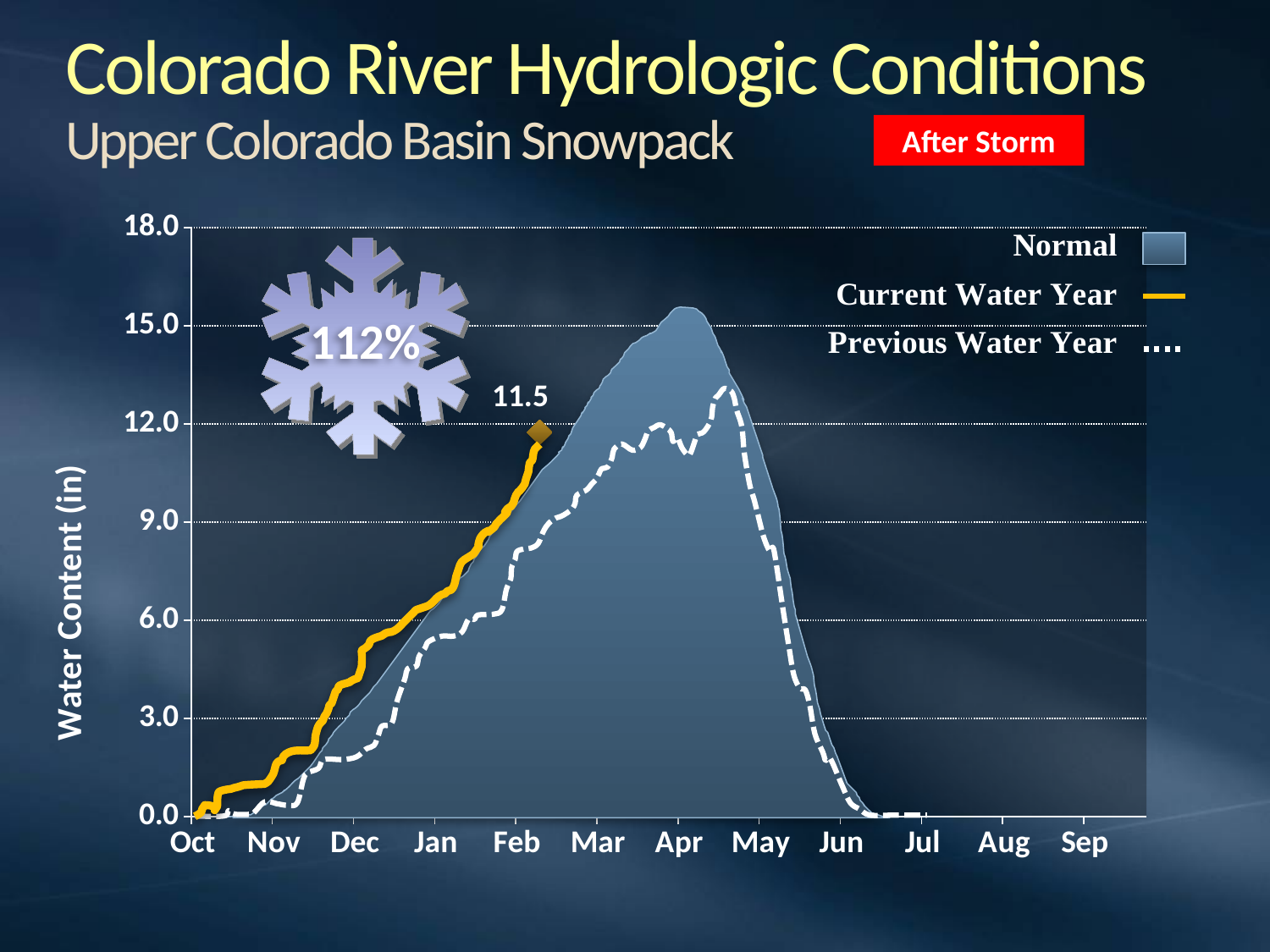
Is the peak of the Normal series greater or less than 15.0? greater At Jan, which is higher: the Current Water Year line or the Previous Water Year line? Current Water Year Around which month does the Normal series reach its highest value? Apr Does the Current Water Year line rise or fall from Oct to Feb? rises What is the value printed at the end of the Current Water Year line? 11.5 What percentage is shown inside the snowflake on the chart? 112% Is the peak of the Previous Water Year line greater or less than 12.0? greater How many months are labelled along the x axis? 12 How many series does the legend list? 3 Is the peak of the Previous Water Year line greater or less than 15.0? less What is the label on the y axis? Water Content (in)